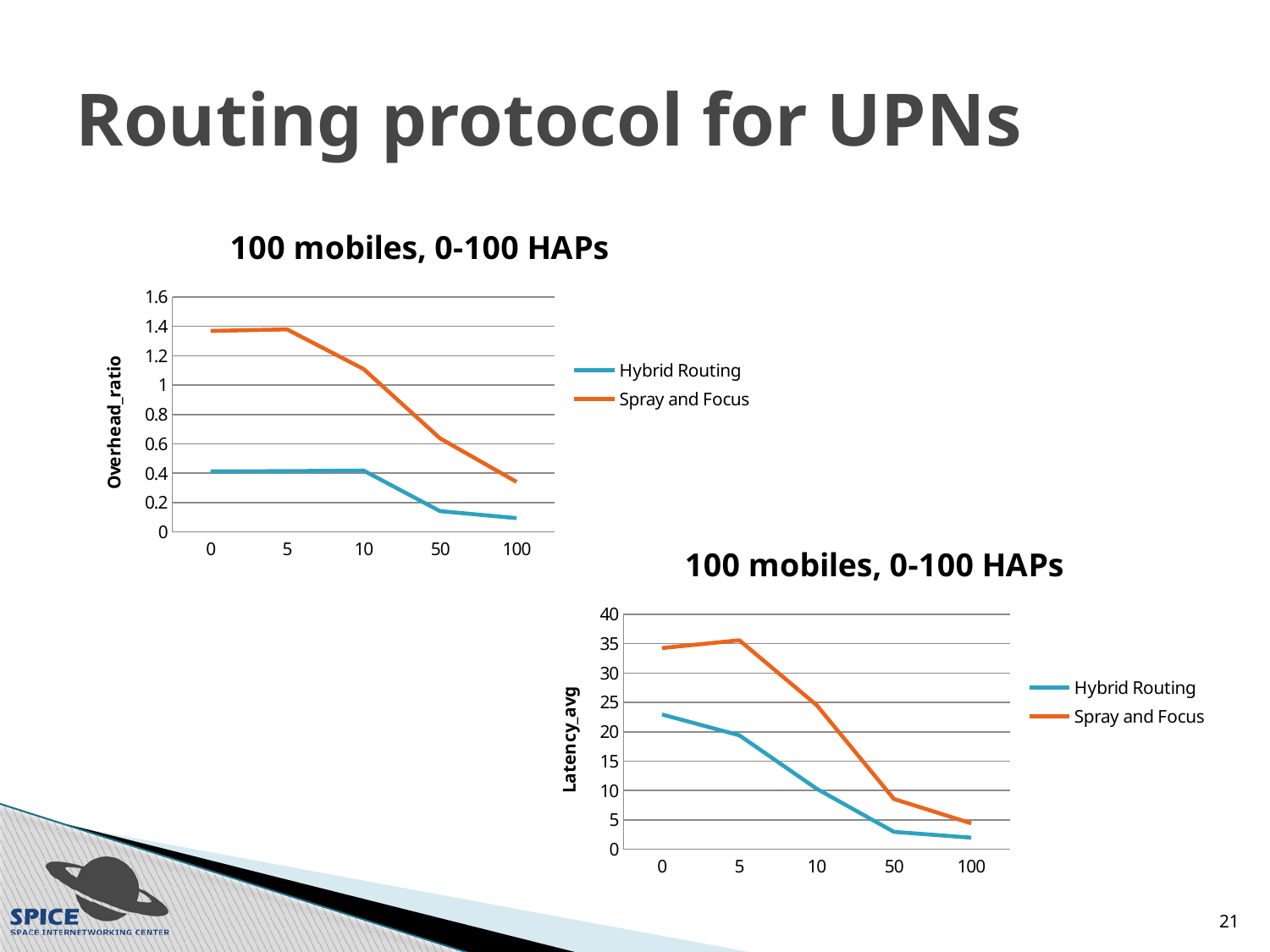
In the bottom-right chart (Latency_avg), is the value for Hybrid Routing at x = 50 greater or less than 5? less In the bottom-right chart (Latency_avg), do the Hybrid Routing values rise or fall as x increases from 0 to 100? Fall What kind of chart is the top-left chart with the Overhead_ratio axis? Line chart In the bottom-right chart (Latency_avg), which series has the higher value at x = 10? Spray and Focus In the top-left chart (Overhead_ratio), what colour is the Spray and Focus line? Orange In the top-left chart (Overhead_ratio), is the value for Hybrid Routing at x = 100 greater or less than 0.2? less In the top-left chart (Overhead_ratio), which series has the higher value at x = 50? Spray and Focus In the top-left chart (Overhead_ratio), is the value for Spray and Focus at x = 0 greater or less than 1.2? greater What is the y-axis label of the bottom-right chart? Latency_avg In the bottom-right chart (Latency_avg), how many x-axis categories are plotted? 5 In the top-left chart (Overhead_ratio), how many series does the legend list? 2